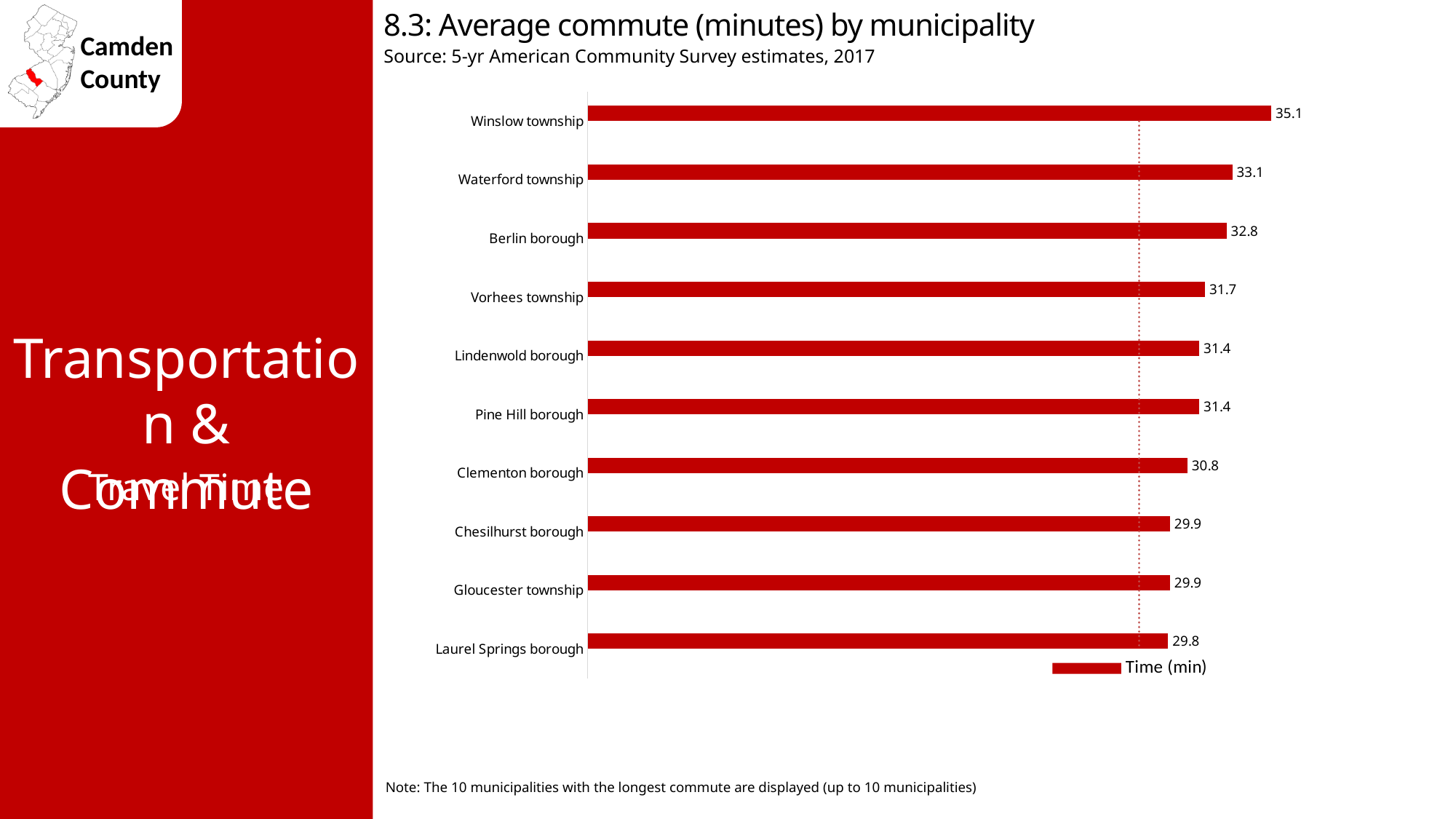
What is the name of the series shown in the chart legend? Time (min) What is the average commute time for Clementon borough? 30.8 Which has a longer average commute, Berlin borough or Lindenwold borough? Berlin borough Which municipality has the shortest average commute shown on the chart? Laurel Springs borough What is the difference in average commute time between Vorhees township and Chesilhurst borough? 1.8 Which municipality has the longest average commute? Winslow township What is the average commute time for Laurel Springs borough? 29.8 How many municipalities are shown on the chart? 10 What type of chart is used to show average commute by municipality? Bar chart What is the average commute time for Winslow township? 35.1 What is the average commute time for Berlin borough? 32.8 What is the difference in average commute time between Winslow township and Waterford township? 2.0